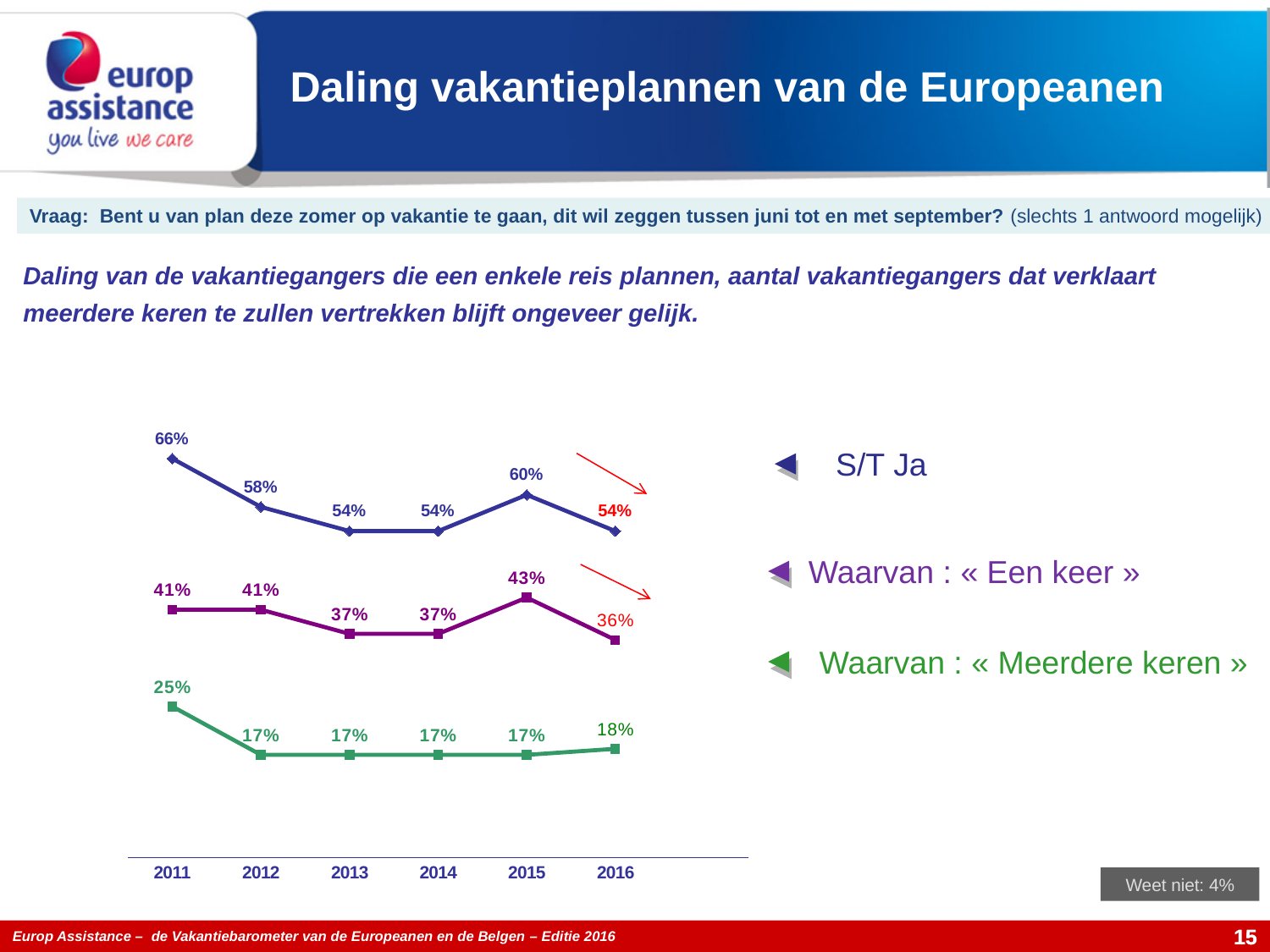
In which year is the Waarvan : « Een keer » series at its lowest? 2016 How many years are shown on the x axis? 6 How many series does the chart show? 3 Which is larger in 2015: the value for Waarvan : « Een keer » or the value for Waarvan : « Meerdere keren »? Waarvan : « Een keer » What is the value for Waarvan : « Een keer » in 2016? 36% In which year is the S/T Ja series at its highest? 2011 What is the difference between the S/T Ja value in 2011 and in 2016? 12% What kind of chart is shown on the slide? Line chart What is the value for S/T Ja in 2011? 66% What is the value for Waarvan : « Meerdere keren » in 2015? 17% Does the S/T Ja series rise or fall from 2015 to 2016? Fall What is the difference between the Waarvan : « Meerdere keren » value in 2011 and in 2012? 8%